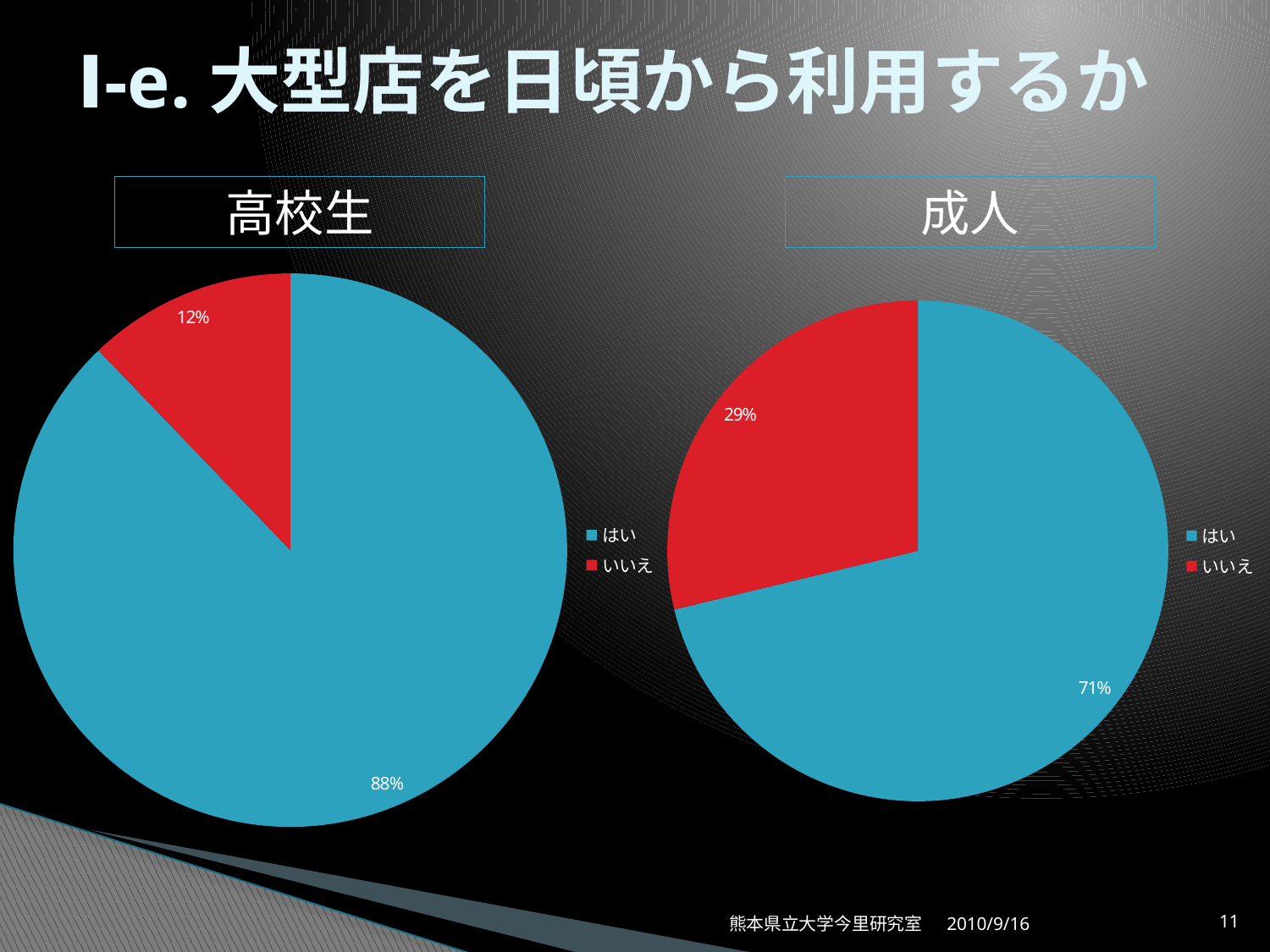
How many entries does the legend of the 高校生 chart list? 2 In the 高校生 pie chart, what percentage is shown for はい? 88% What type of chart is used for the 高校生 data? Pie chart Is the いいえ share larger in the 高校生 chart or the 成人 chart? 成人 In the 高校生 chart, which category has the largest slice? はい In the 成人 pie chart, what percentage is shown for はい? 71% In the 成人 chart, what is the difference between the はい and いいえ percentages? 42% In the 高校生 pie chart, what percentage is shown for いいえ? 12% In the 成人 chart, which category has the smallest slice? いいえ In the 成人 pie chart, what percentage is shown for いいえ? 29% In the 成人 chart, what colour is the いいえ slice? Red How many slices does the 成人 pie chart have? 2